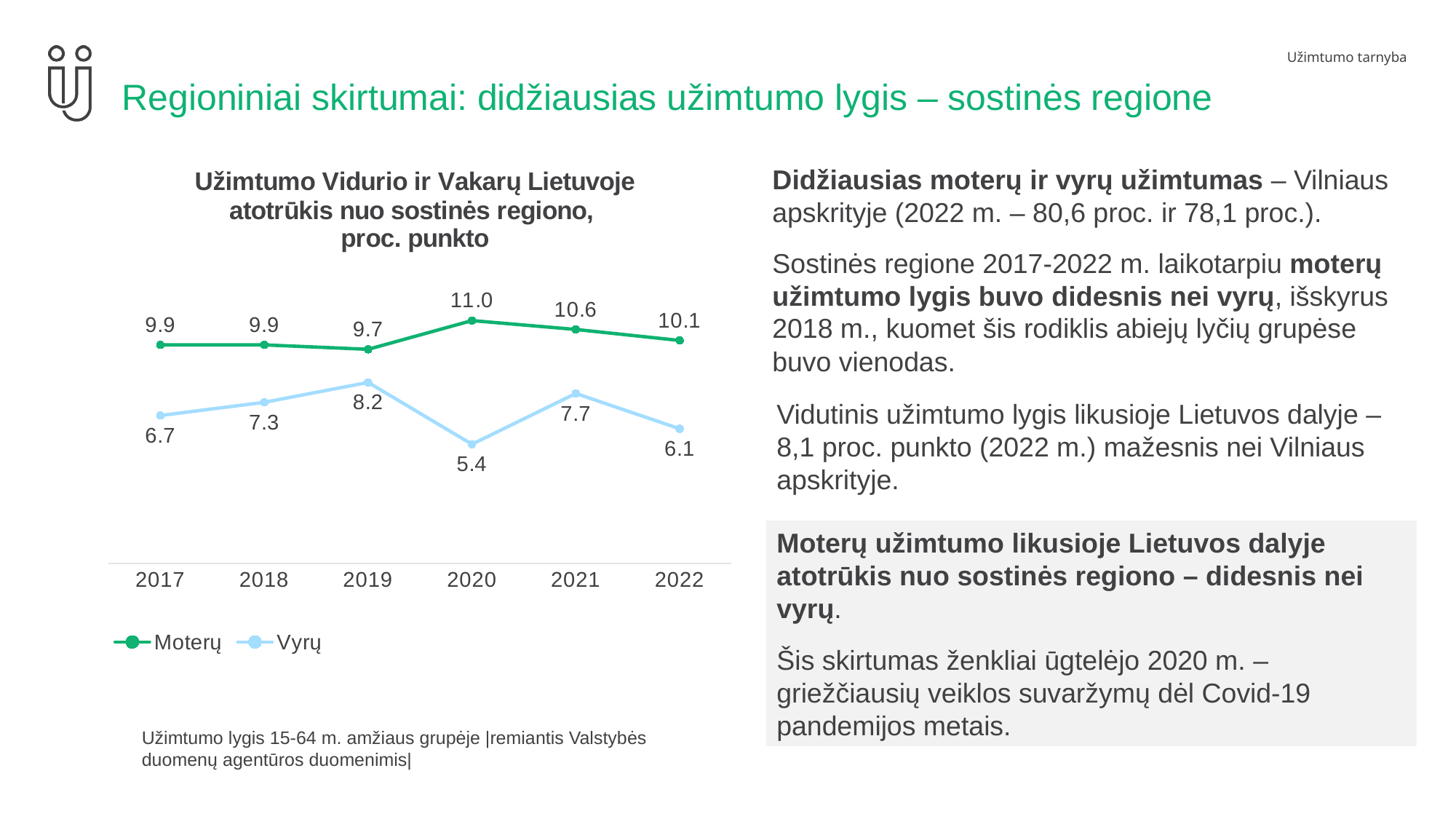
What is the value for Vyrų in 2019? 8.2 What is the value for Moterų in 2020? 11.0 How many series does the legend list? 2 Does the Vyrų series rise or fall from 2021 to 2022? Fall What is the value for Vyrų in 2022? 6.1 Which is larger in 2021, the Moterų value or the Vyrų value? Moterų What is the difference between the Moterų and Vyrų values in 2020? 5.6 In which year is the Moterų series highest? 2020 How many years are shown on the x axis? 6 In which year is the Vyrų series lowest? 2020 What kind of chart is shown on the slide? Line chart Which series is drawn in green? Moterų